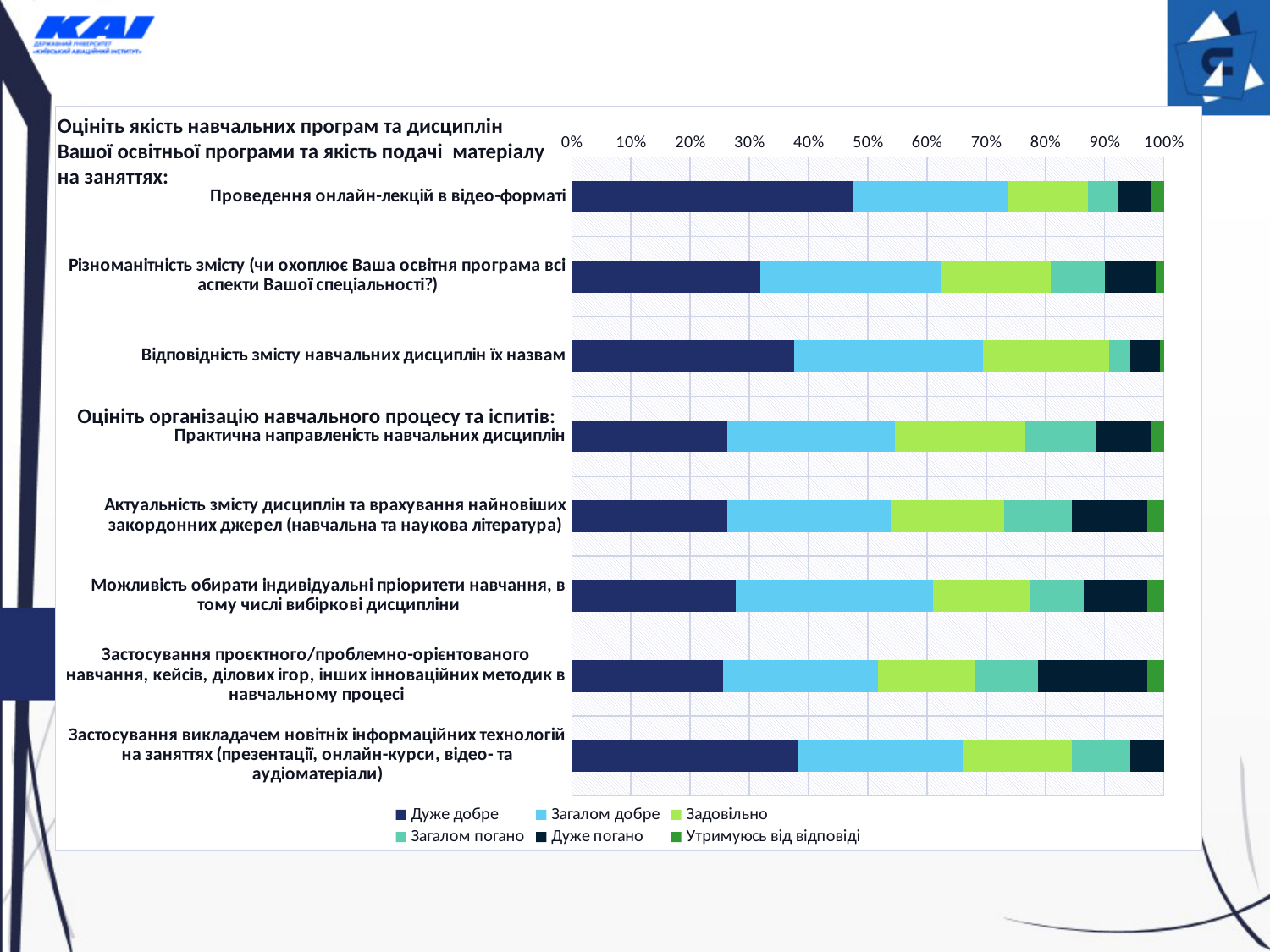
Is the 'Дуже добре' share for 'Відповідність змісту навчальних дисциплін їх назвам' greater or less than 30%? greater Which has a larger 'Дуже добре' share: 'Проведення онлайн-лекцій в відео-форматі' or 'Практична направленість навчальних дисциплін'? Проведення онлайн-лекцій в відео-форматі How many series does the legend list? 6 Which has a larger 'Дуже добре' share: 'Відповідність змісту навчальних дисциплін їх назвам' or 'Можливість обирати індивідуальні пріоритети навчання, в тому числі вибіркові дисципліни'? Відповідність змісту навчальних дисциплін їх назвам How many categories (survey questions) are plotted on the chart? 8 Is the 'Дуже добре' share for 'Проведення онлайн-лекцій в відео-форматі' greater or less than 40%? greater What is the highest value shown on the horizontal axis? 100% Which category has the largest 'Дуже погано' share? Застосування проєктного/проблемно-орієнтованого навчання, кейсів, ділових ігор, інших інноваційних методик в навчальному процесі What is the first entry in the chart legend? Дуже добре What kind of chart is shown on the slide? Stacked horizontal bar chart Is the 'Дуже добре' share for 'Застосування проєктного/проблемно-орієнтованого навчання, кейсів, ділових ігор, інших інноваційних методик в навчальному процесі' greater or less than 30%? less Which category has the largest 'Дуже добре' share? Проведення онлайн-лекцій в відео-форматі